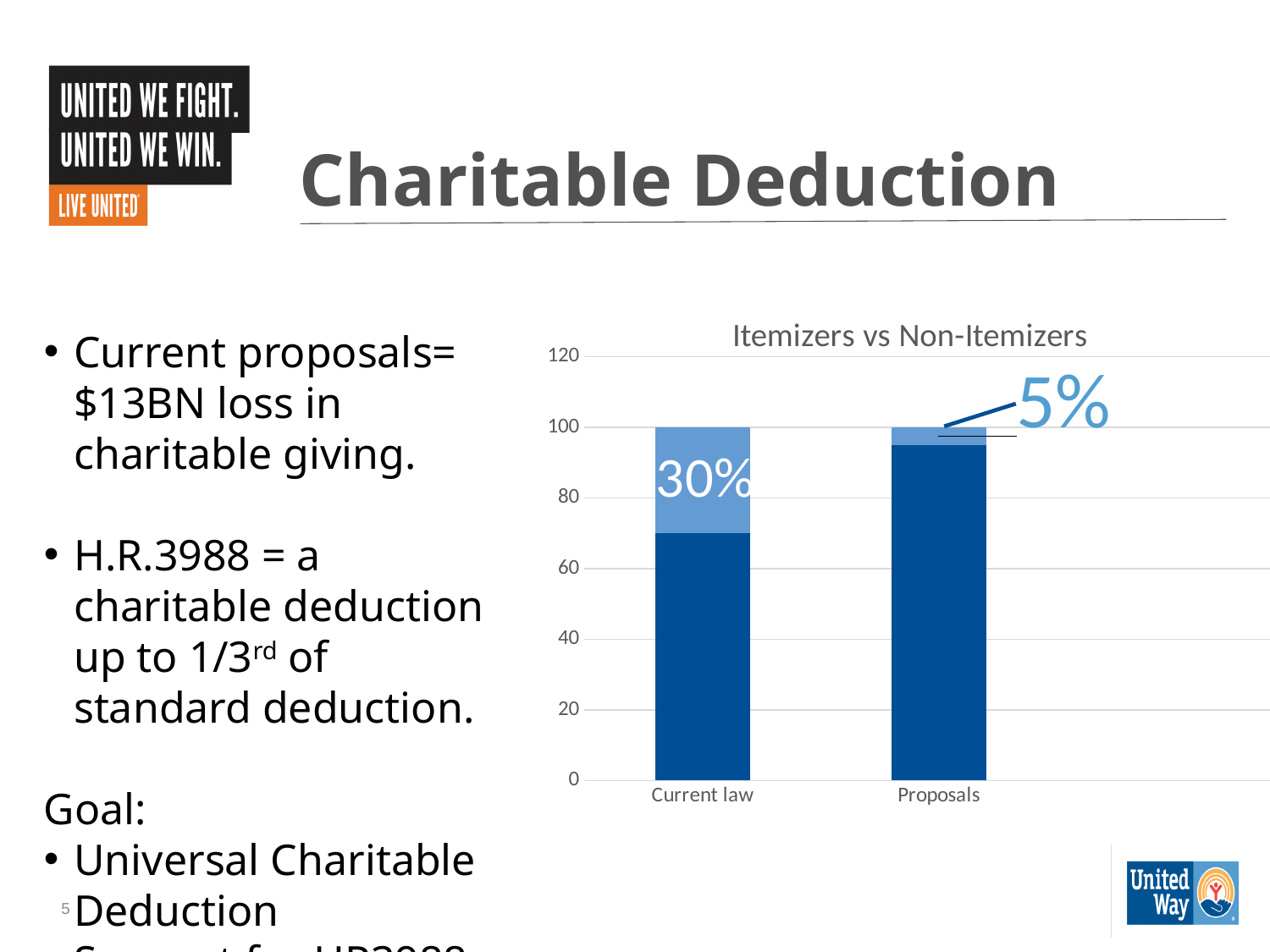
Is the dark blue segment of the Current law bar greater or less than 60? greater What is the difference between the light blue segment labels for Current law and Proposals? 25% Which category has the larger light blue segment, Current law or Proposals? Current law What is the highest value shown on the y axis of the chart? 120 How many categories are shown on the x axis of the chart? 2 What percentage label is shown for the light blue segment of the Proposals bar? 5% What is the total height of the Proposals stacked bar? 100 What is the total height of the Current law stacked bar? 100 What kind of chart is shown on the slide? stacked bar chart What is the title of the chart? Itemizers vs Non-Itemizers What percentage label is shown on the light blue segment of the Current law bar? 30% Is the dark blue segment of the Proposals bar greater or less than 80? greater